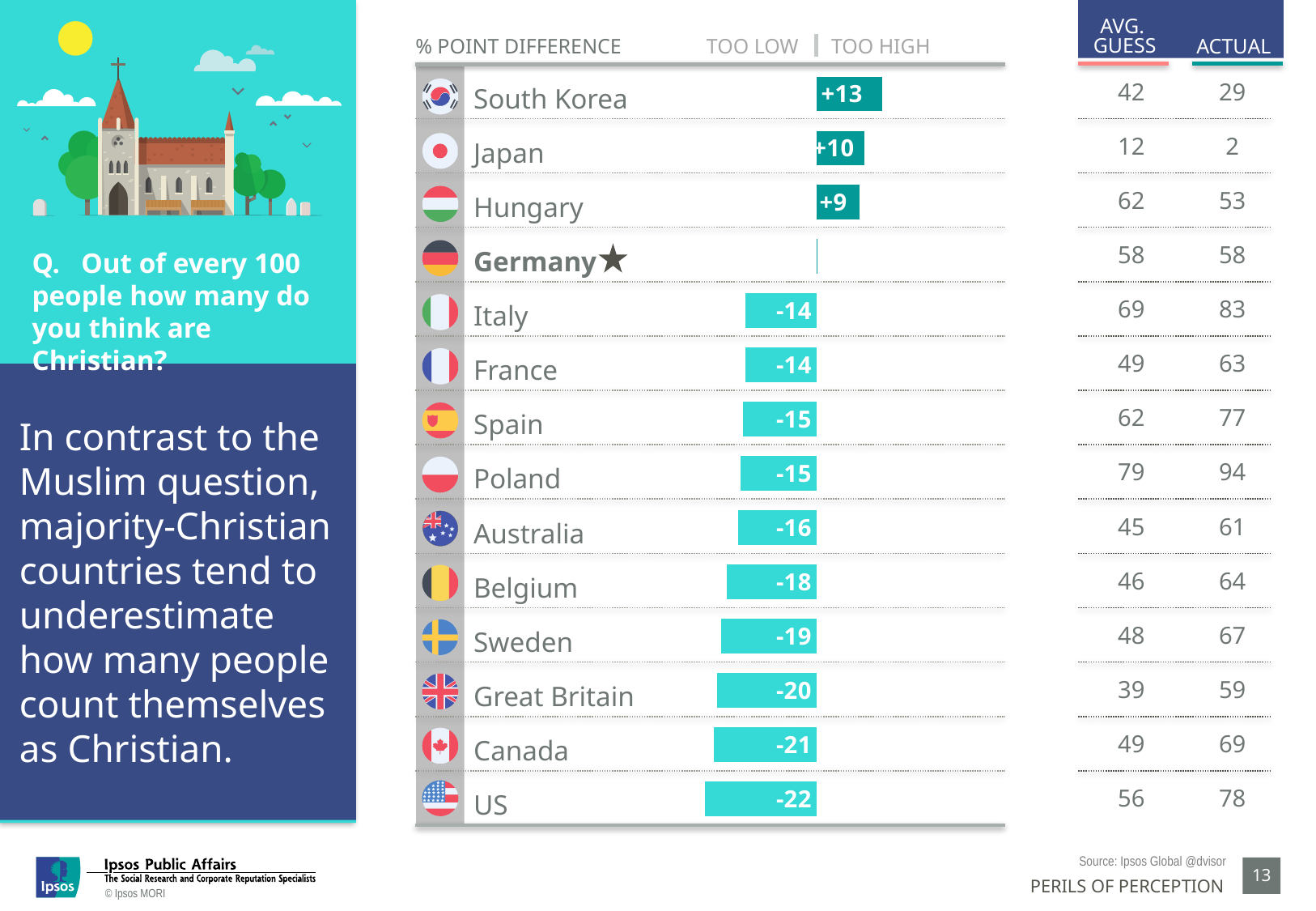
How many countries have a positive (too high) % point difference? 3 What is the % point difference for Canada? -21 What is the difference in % points between South Korea's value and the US value? 35 How many countries are listed in the % point difference chart? 14 Which country has the highest % point difference? South Korea What kind of chart is used to show the % point difference by country? bar chart Which country has the larger underestimate, Belgium or Australia? Belgium What is the % point difference for Hungary? +9 What is the % point difference for Japan? +10 Which country has no bar shown in the % point difference chart? Germany What is the title of the chart's value column on the left? % POINT DIFFERENCE Which country has the lowest % point difference? US